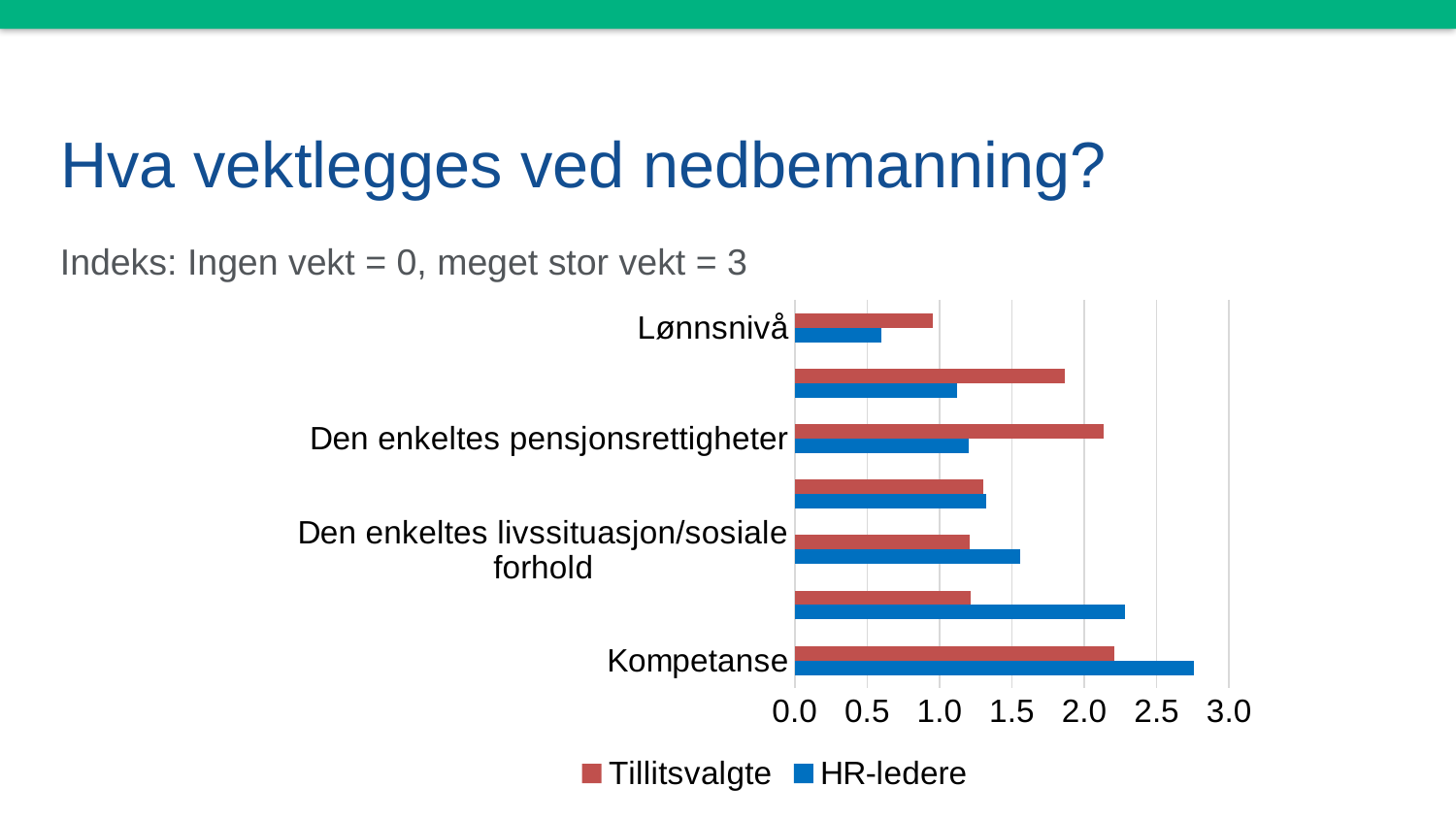
What kind of chart is shown on the slide? Bar chart Which labelled category has the highest HR-ledere value? Kompetanse Is the Tillitsvalgte value for Den enkeltes pensjonsrettigheter greater or less than 2.0? greater Is the HR-ledere value for Den enkeltes pensjonsrettigheter greater or less than 1.5? less Is the HR-ledere value for Lønnsnivå greater or less than 1.0? less How many categories (pairs of bars) are plotted in the chart? 7 For Kompetanse, which series has the larger value, Tillitsvalgte or HR-ledere? HR-ledere For Den enkeltes pensjonsrettigheter, which series has the larger value, Tillitsvalgte or HR-ledere? Tillitsvalgte How many series does the legend list? 2 What colour are the bars for HR-ledere? Blue Which two series are listed in the legend? Tillitsvalgte and HR-ledere